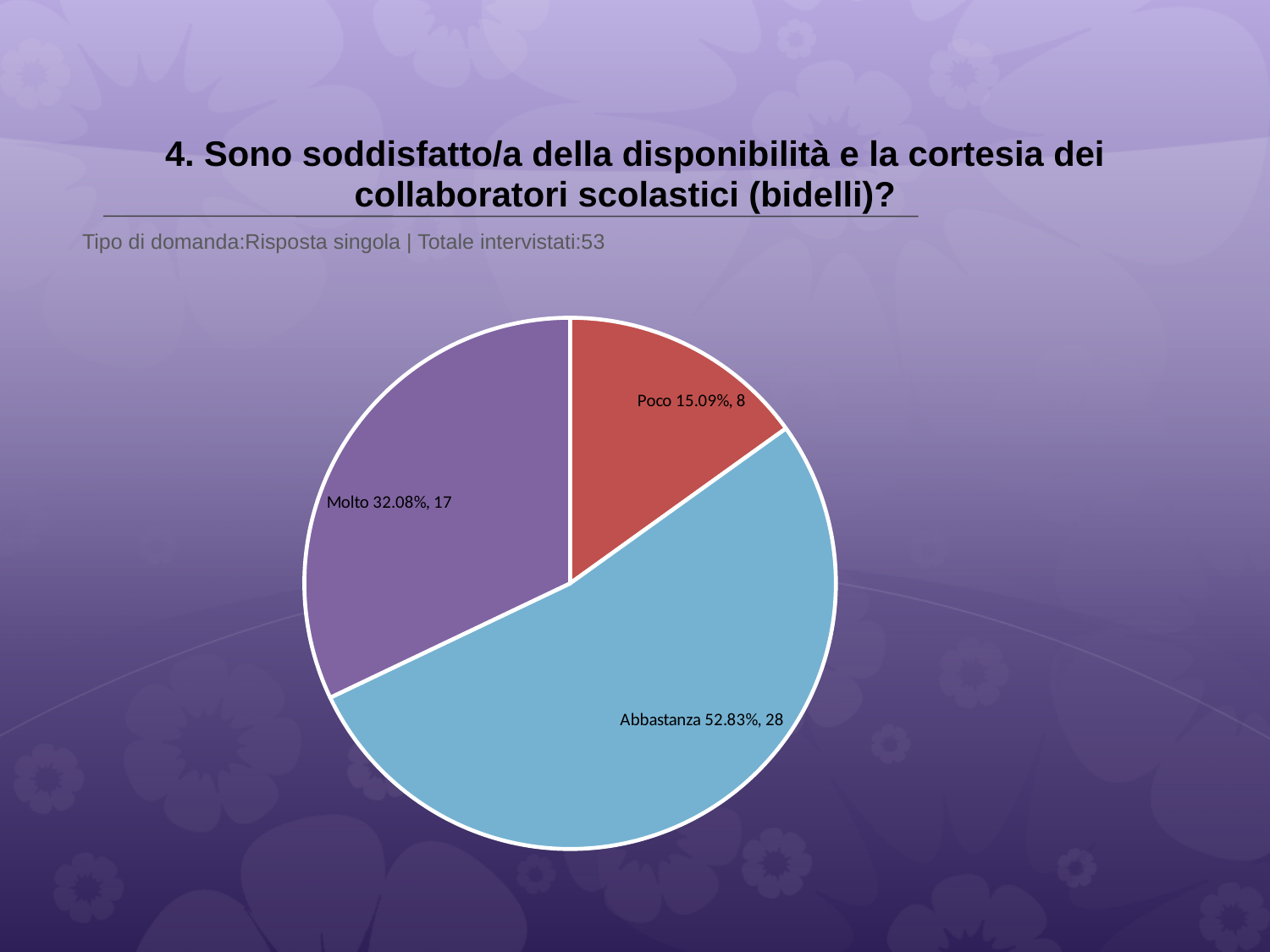
What percentage share does the Poco slice have? 15.09% How many respondents answered Poco? 8 Which response has the largest slice of the pie? Abbastanza What percentage share does the Abbastanza slice have? 52.83% How many respondents answered Molto? 17 Which has more respondents, Molto or Poco? Molto What is the difference in respondent count between Abbastanza and Molto? 11 How many slices does the pie chart have? 3 Which response has the smallest slice of the pie? Poco What colour is the Abbastanza slice? blue What kind of chart is shown on the slide? pie chart What is the total number of respondents across all three slices? 53